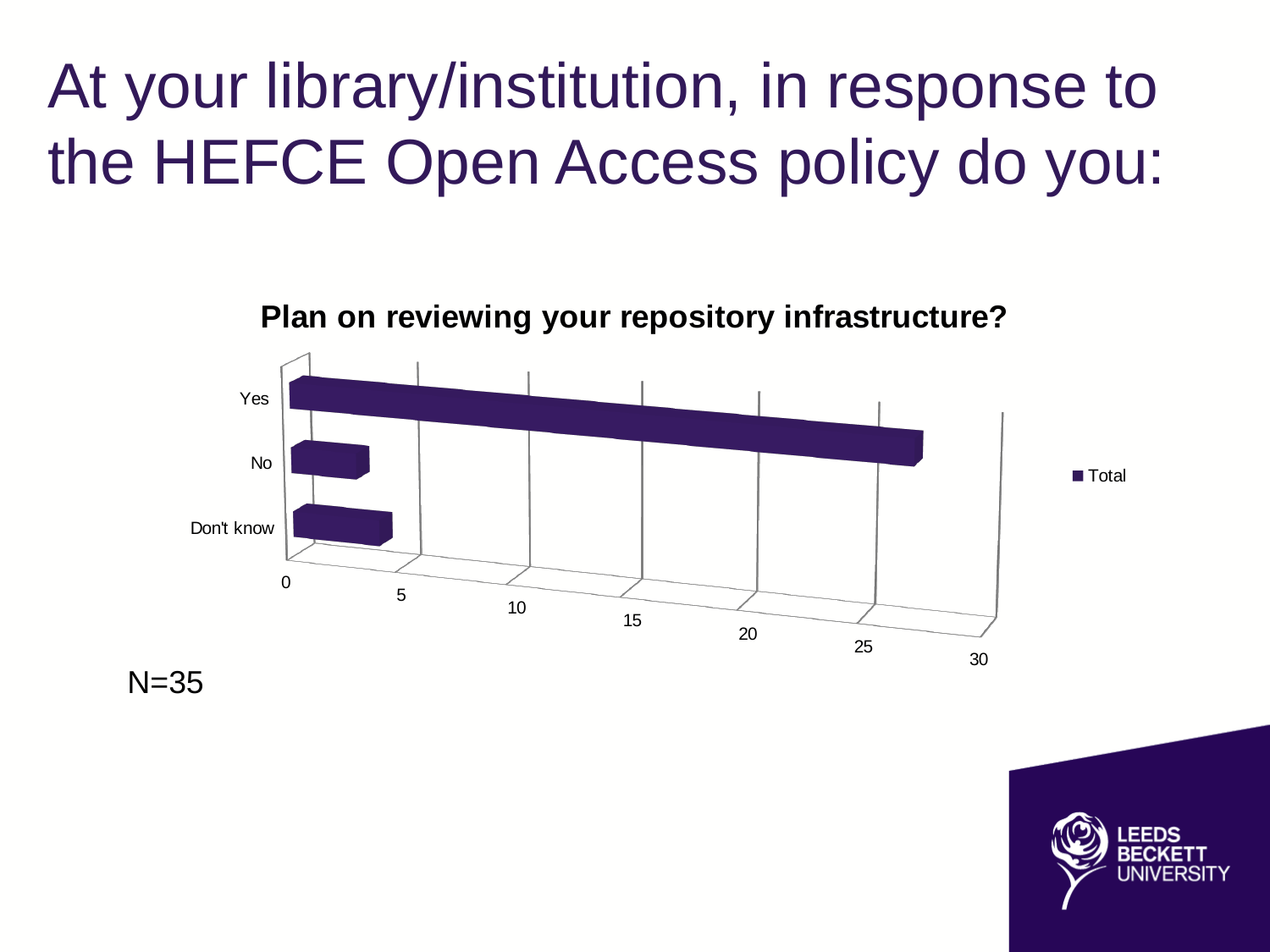
Is the value for Don't know greater or less than 10? less Which is larger, the value for Yes or the value for No? Yes Which category has the highest value? Yes How many series does the legend list? 1 Is the value for No greater or less than 5? less What is the name of the series shown in the legend? Total What is the title of the chart? Plan on reviewing your repository infrastructure? What type of chart is shown on the slide? Bar chart Which is larger, the value for Yes or the value for Don't know? Yes How many categories are shown on the chart? 3 Is the value for Yes greater or less than 20? greater